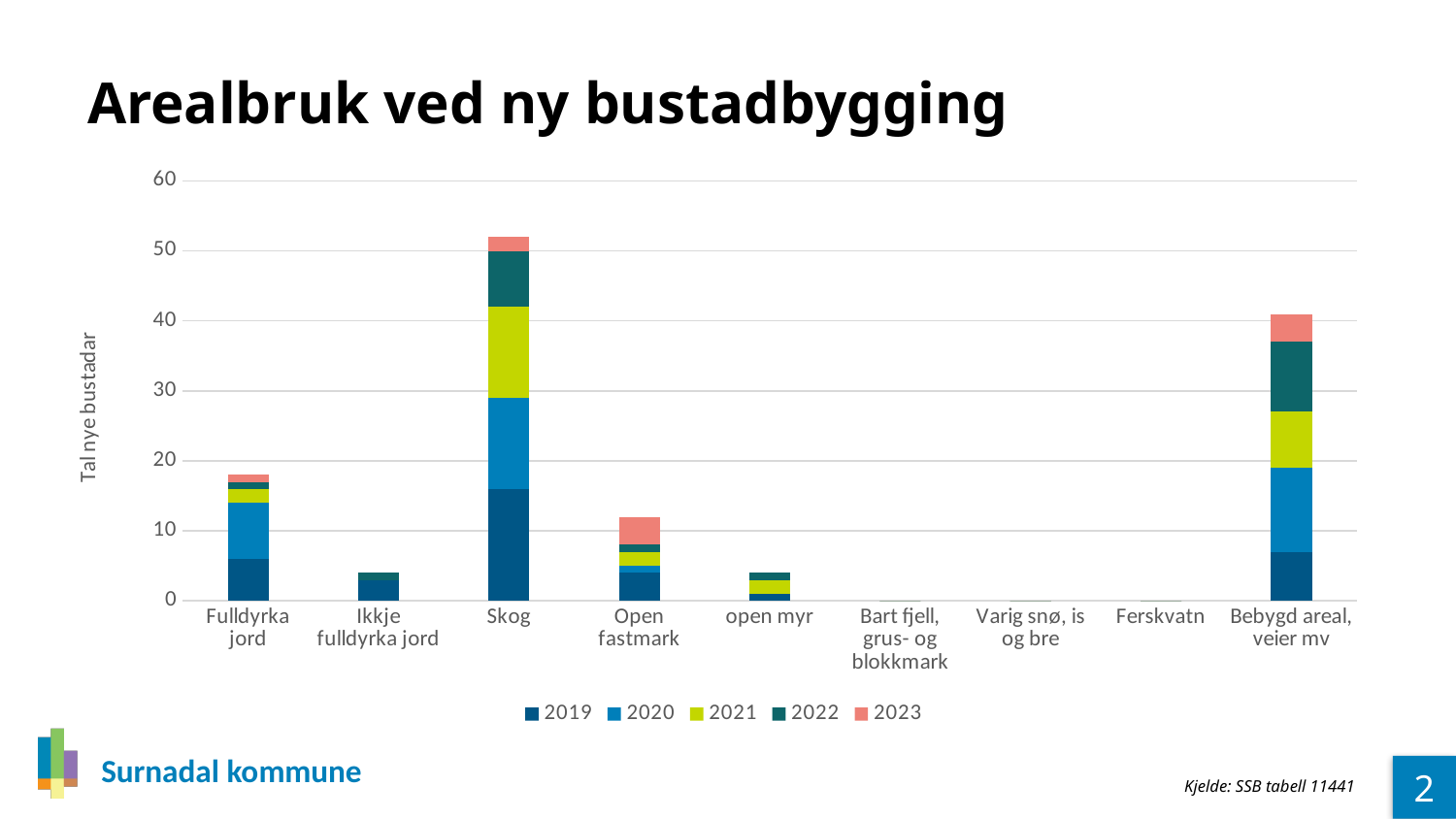
Which stacked bar is taller, Fulldyrka jord or Open fastmark? Fulldyrka jord Which category has the tallest stacked bar? Skog Which stacked bar is taller, Skog or Bebygd areal, veier mv? Skog What is the title of the chart? Arealbruk ved ny bustadbygging Is the total stacked value for Skog greater or less than 40? greater How many categories are shown along the x axis? 9 What is the label on the y axis? Tal nye bustadar What kind of chart is shown on the slide? Stacked bar chart Is the total stacked value for Ikkje fulldyrka jord greater or less than 10? less Is the total stacked value for Bebygd areal, veier mv greater or less than 30? greater How many series does the legend list? 5